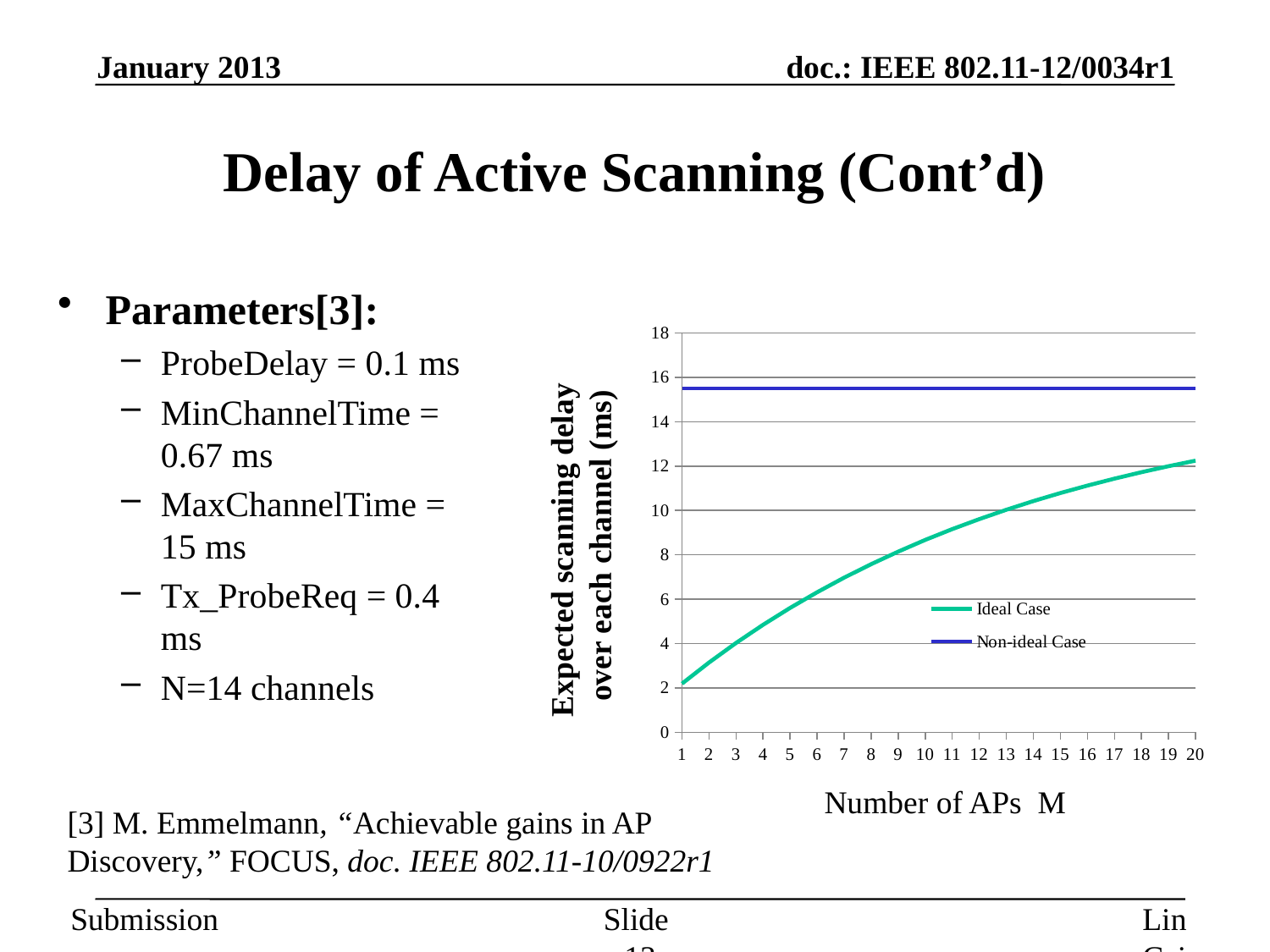
Is the Non-ideal Case value greater or less than 14? greater Does the Ideal Case line rise or fall as the number of APs M increases? rises Is the Ideal Case value at M=20 greater or less than 10? greater Does the Non-ideal Case line rise, fall, or stay flat as the number of APs M increases? stays flat Is the Ideal Case value at M=1 greater or less than 4? less What are the two series named in the chart legend? Ideal Case and Non-ideal Case How many series does the chart legend list? 2 At M=10, which series has the higher expected scanning delay, Ideal Case or Non-ideal Case? Non-ideal Case What is the label of the chart's y axis? Expected scanning delay over each channel (ms) How many values of M (number of APs) are shown along the x axis? 20 What kind of chart is shown on the slide? line chart